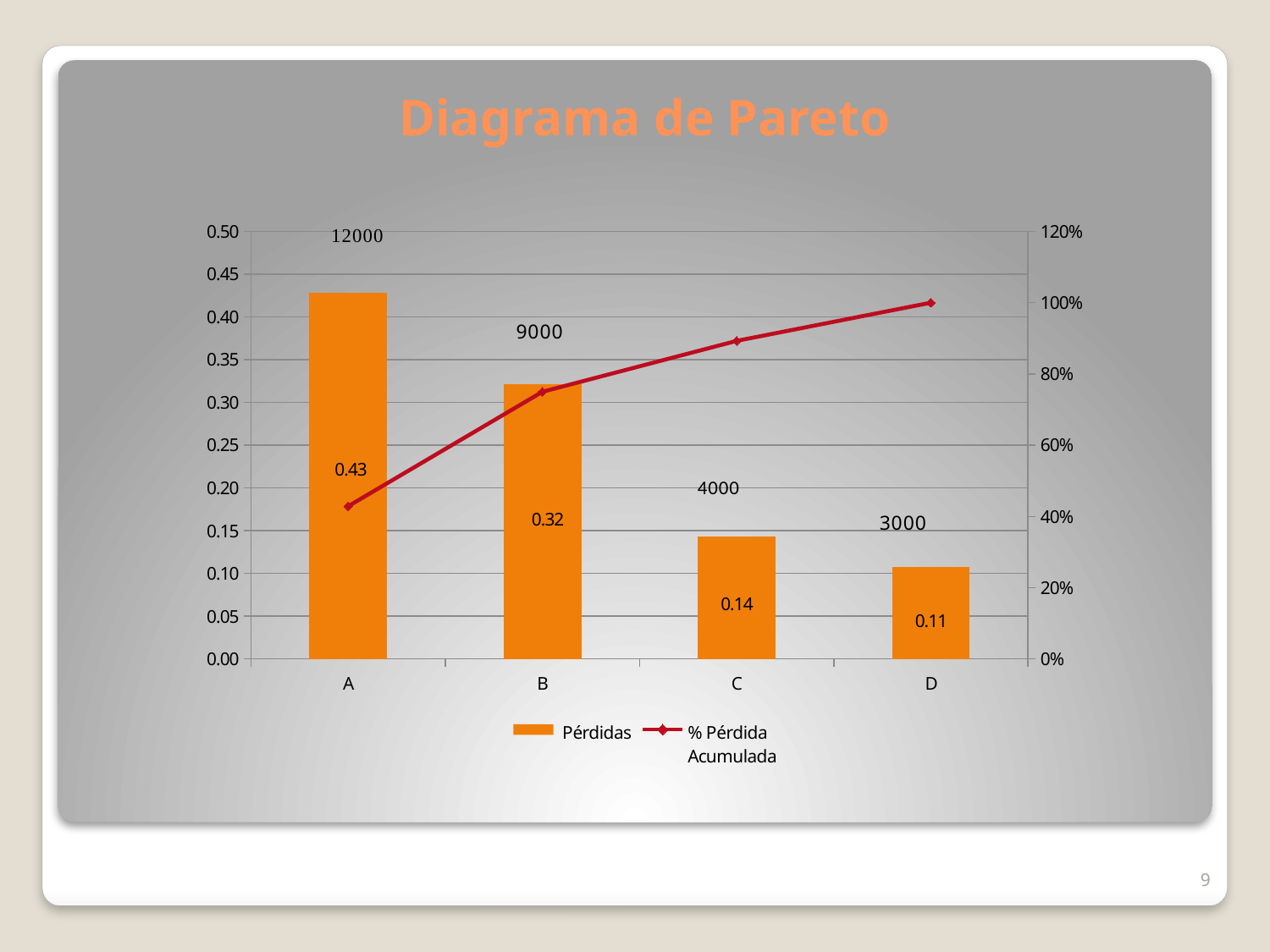
Which category has the lowest Pérdidas value? D Do the Pérdidas bar values rise or fall from A to D? fall What is the Pérdidas value for category A? 0.43 What is the Pérdidas value for category C? 0.14 Which has a larger Pérdidas value, category C or category D? C Is the % Pérdida Acumulada value for category A greater or less than 60%? less Is the % Pérdida Acumulada value for category B greater or less than 60%? greater What number is printed above the bar for category B? 9000 What is the difference between the Pérdidas values for A and B? 0.11 How many series does the legend list? 2 How many categories are shown on the x axis? 4 Which category has the highest Pérdidas value? A